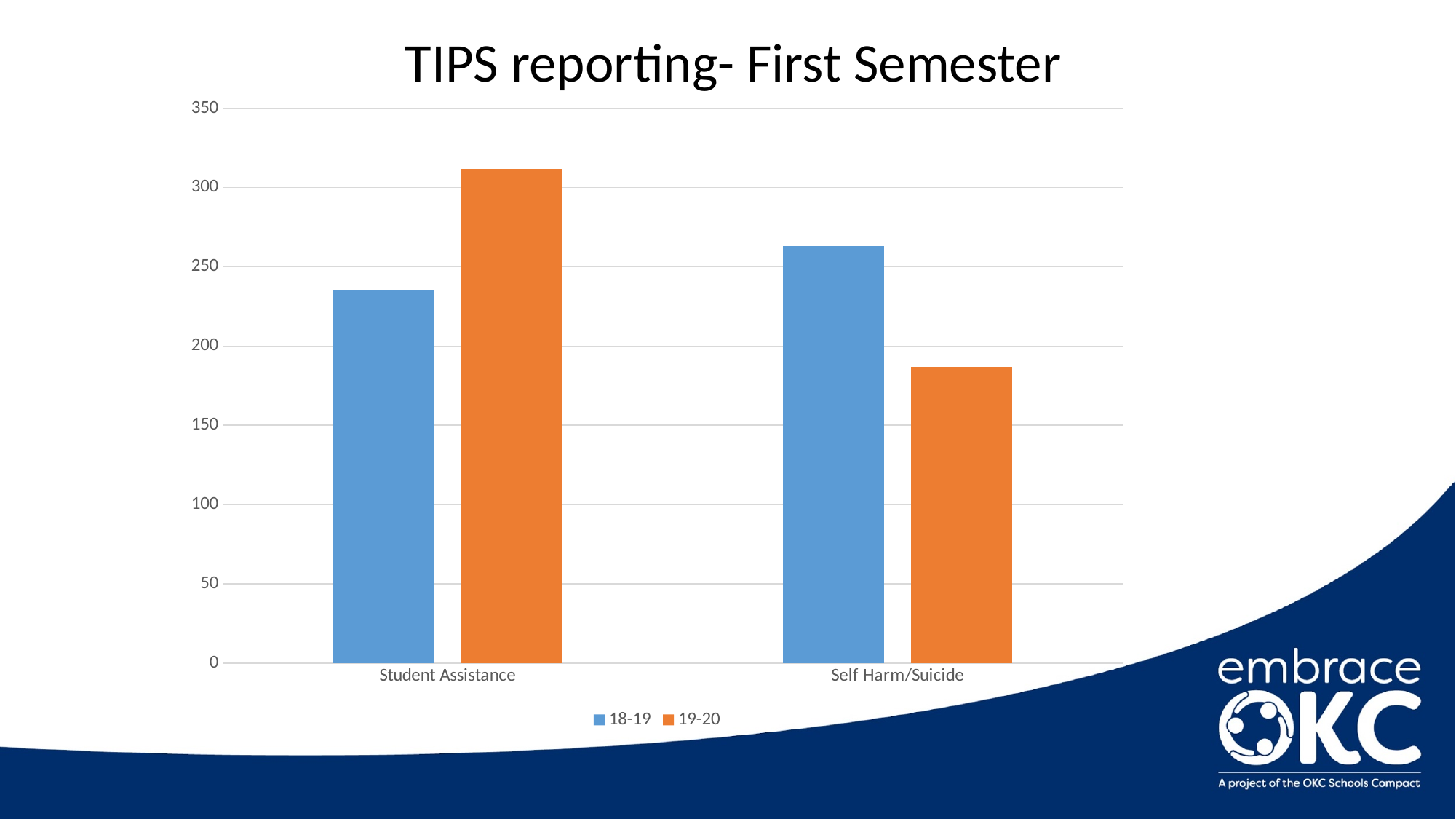
For Student Assistance, which series has the larger value, 18-19 or 19-20? 19-20 Is the 18-19 value for Student Assistance greater or less than 250? less Which bar is the tallest in the chart? 19-20 for Student Assistance What is the title of the chart? TIPS reporting- First Semester What type of chart is shown on the slide? bar chart How many categories are shown on the x axis? 2 Is the 18-19 value for Self Harm/Suicide greater or less than 250? greater Is the 19-20 value for Student Assistance greater or less than 300? greater For Self Harm/Suicide, which series has the larger value, 18-19 or 19-20? 18-19 Which series is shown in orange? 19-20 How many series does the legend list? 2